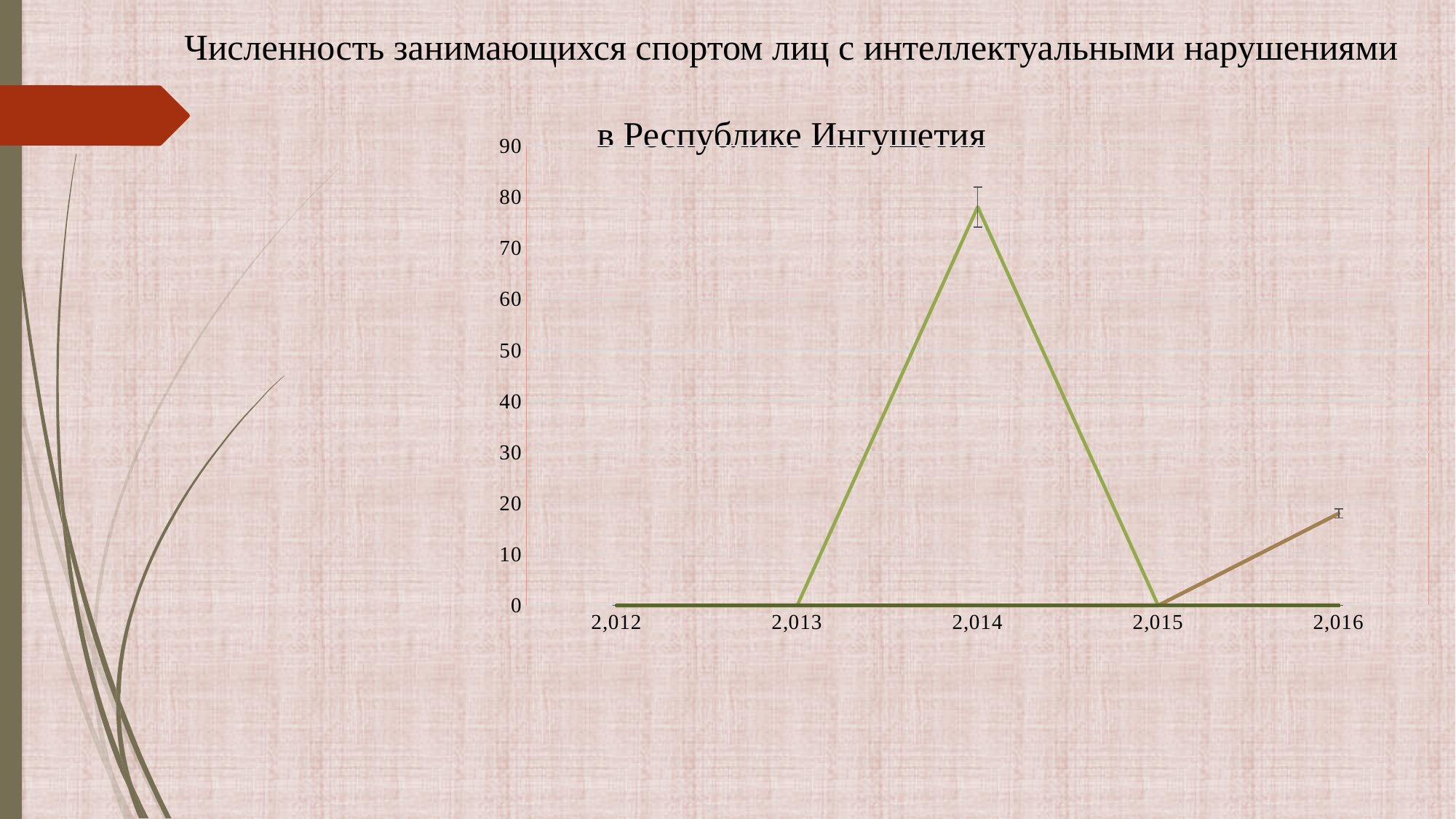
Is the value for 2,014 greater or less than 70? greater Which year has the highest value on the chart? 2,014 What kind of chart is shown on the slide? line chart How many years are shown on the x axis of the chart? 5 Is the value for 2,016 greater or less than 20? less What is the value plotted for 2,015? 0 Which is larger, the value for 2,014 or the value for 2,016? 2,014 Does the value rise or fall from 2,014 to 2,015? fall Is the value for 2,016 greater or less than 10? greater What is the highest tick value shown on the y axis of the chart? 90 Does the value rise or fall from 2,015 to 2,016? rise What is the value plotted for 2,013? 0